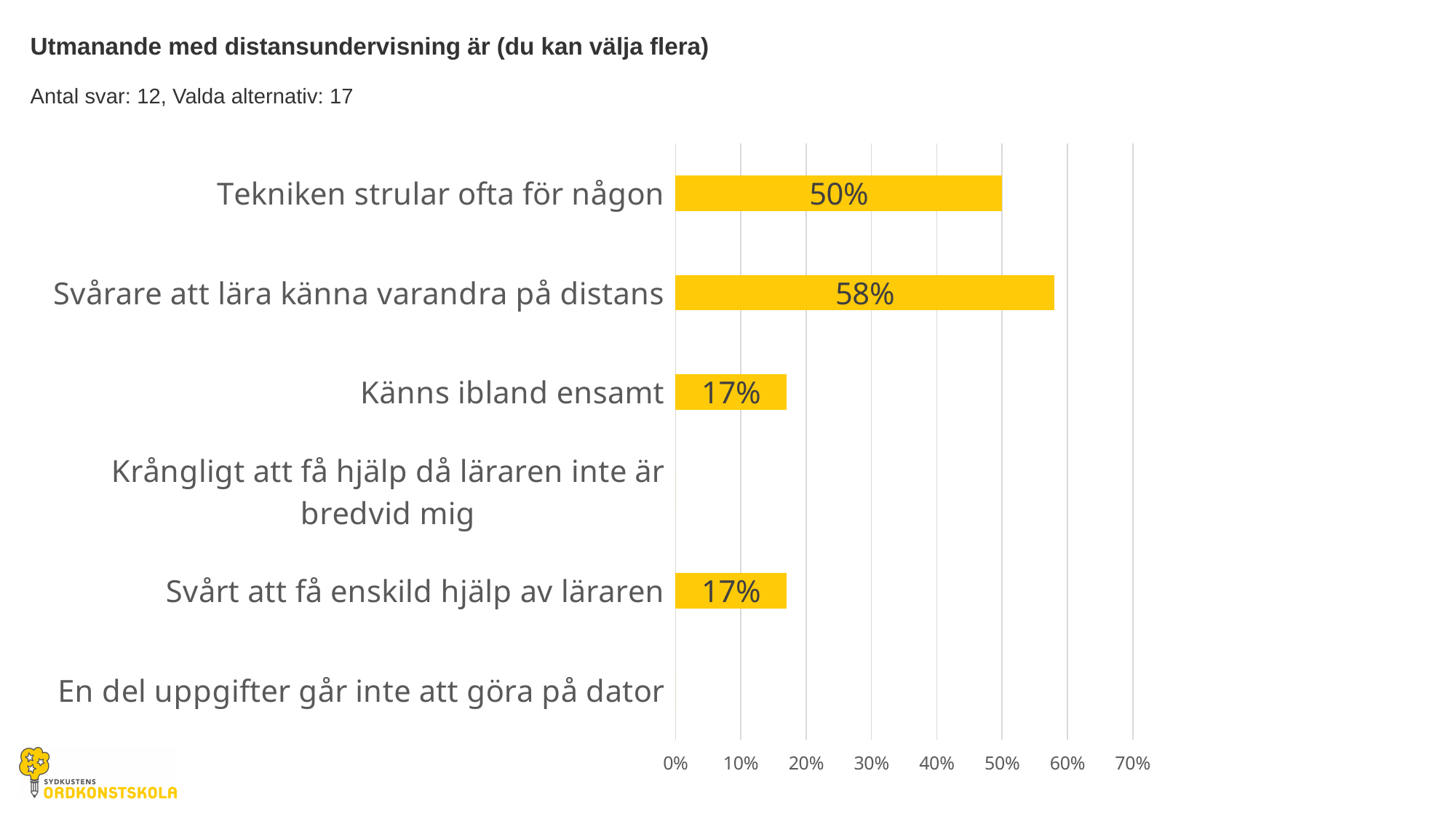
What is the value for "Svårare att lära känna varandra på distans"? 58% What is the title of the chart? Utmanande med distansundervisning är (du kan välja flera) Is the value for "Svårare att lära känna varandra på distans" greater or less than 50%? greater Which category has the highest value? Svårare att lära känna varandra på distans How many categories are shown on the chart? 6 What is the value for "Känns ibland ensamt"? 17% Which is larger, "Tekniken strular ofta för någon" or "Känns ibland ensamt"? Tekniken strular ofta för någon What is the value for "Tekniken strular ofta för någon"? 50% What kind of chart is shown on the slide? bar chart What is the difference between "Svårare att lära känna varandra på distans" and "Tekniken strular ofta för någon"? 8% What is the value for "Svårt att få enskild hjälp av läraren"? 17% What is the difference between "Tekniken strular ofta för någon" and "Känns ibland ensamt"? 33%